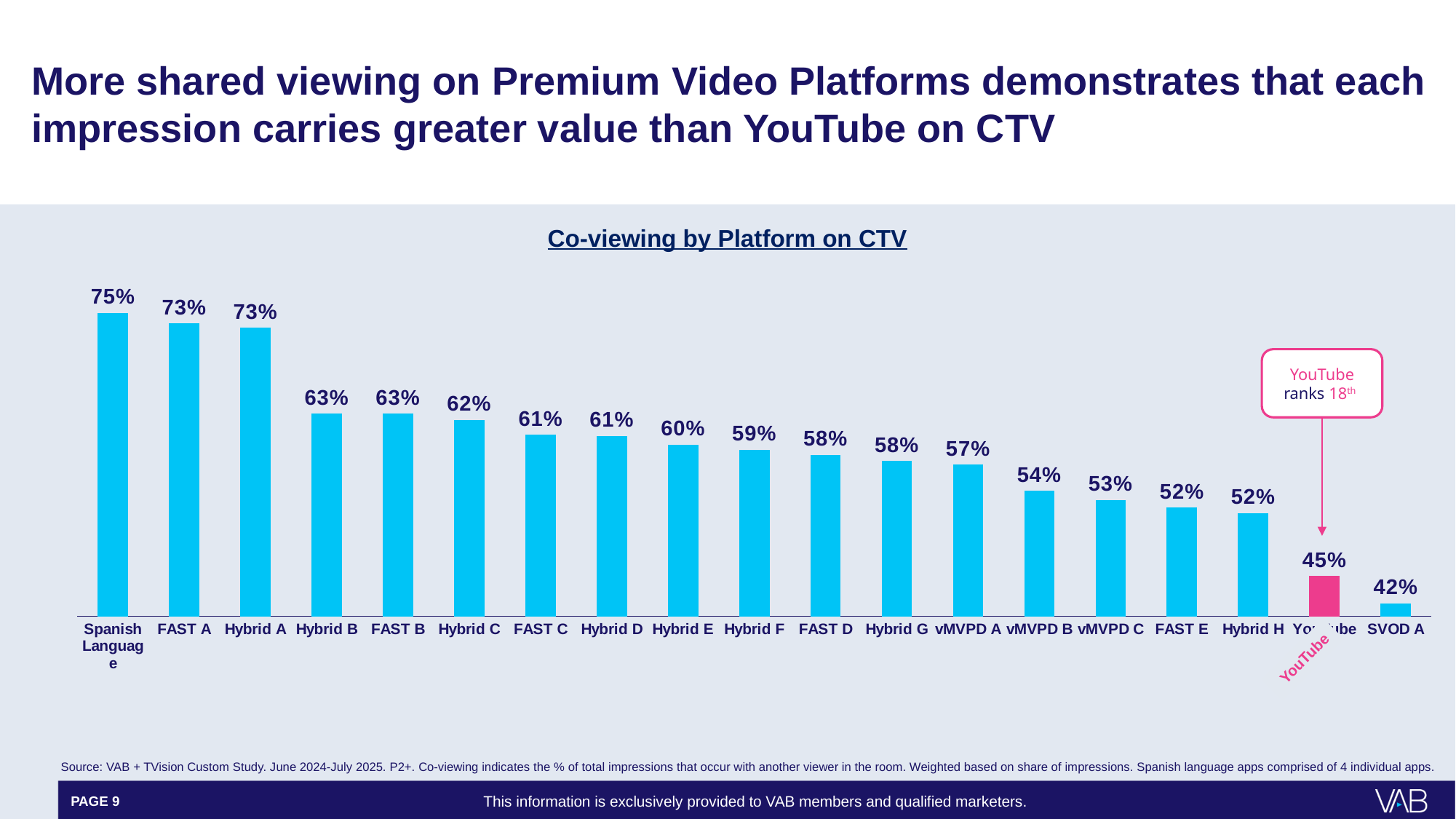
What is the co-viewing value for YouTube? 45% What is the difference between the co-viewing values for Spanish Language and YouTube? 30% What kind of chart is shown on the slide? Bar chart What is the title of the chart? Co-viewing by Platform on CTV What is the co-viewing value for Spanish Language? 75% What is the co-viewing value for Hybrid E? 60% Which platform has the highest co-viewing value? Spanish Language What is the difference between the co-viewing values for Hybrid B and FAST E? 11% How many platforms are shown in the chart? 19 What is the co-viewing value for vMVPD B? 54% Which has a higher co-viewing value, FAST D or vMVPD C? FAST D Which platform has the lowest co-viewing value? SVOD A